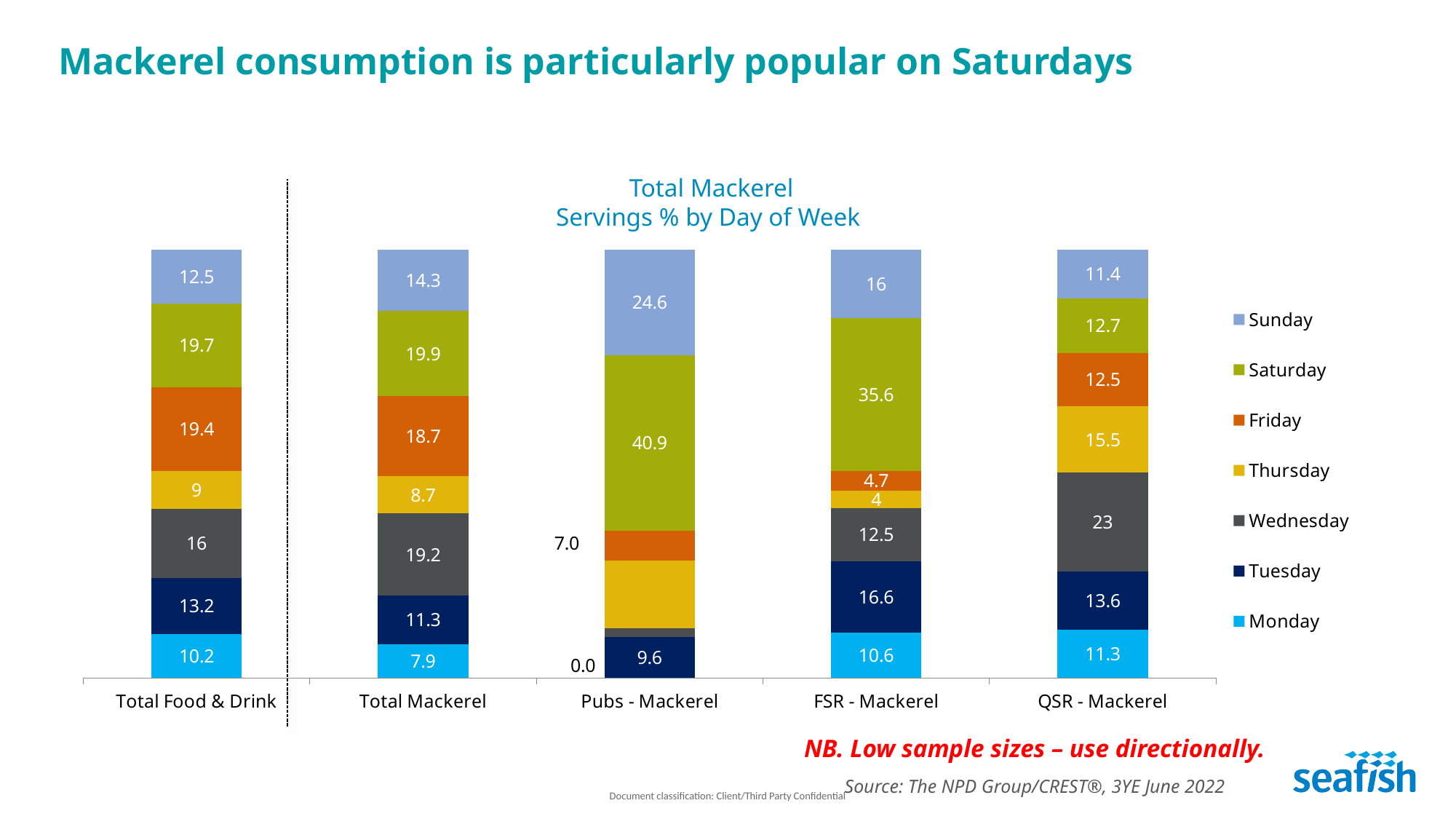
Which day has the lowest value in the FSR - Mackerel bar? Thursday Which is larger: the Friday value for Total Food & Drink or the Friday value for Total Mackerel? Total Food & Drink What kind of chart is shown on the slide? Stacked bar chart What is the title of the chart? Total Mackerel Servings % by Day of Week What is the Monday value for Total Mackerel? 7.9 What is the Saturday value for Pubs - Mackerel? 40.9 Which category has the highest Saturday value? Pubs - Mackerel What is the difference between the Saturday values for Pubs - Mackerel and FSR - Mackerel? 5.3 What is the Sunday value for FSR - Mackerel? 16 How many series does the legend list? 7 What is the Wednesday value for QSR - Mackerel? 23 How many categories are shown on the x axis? 5